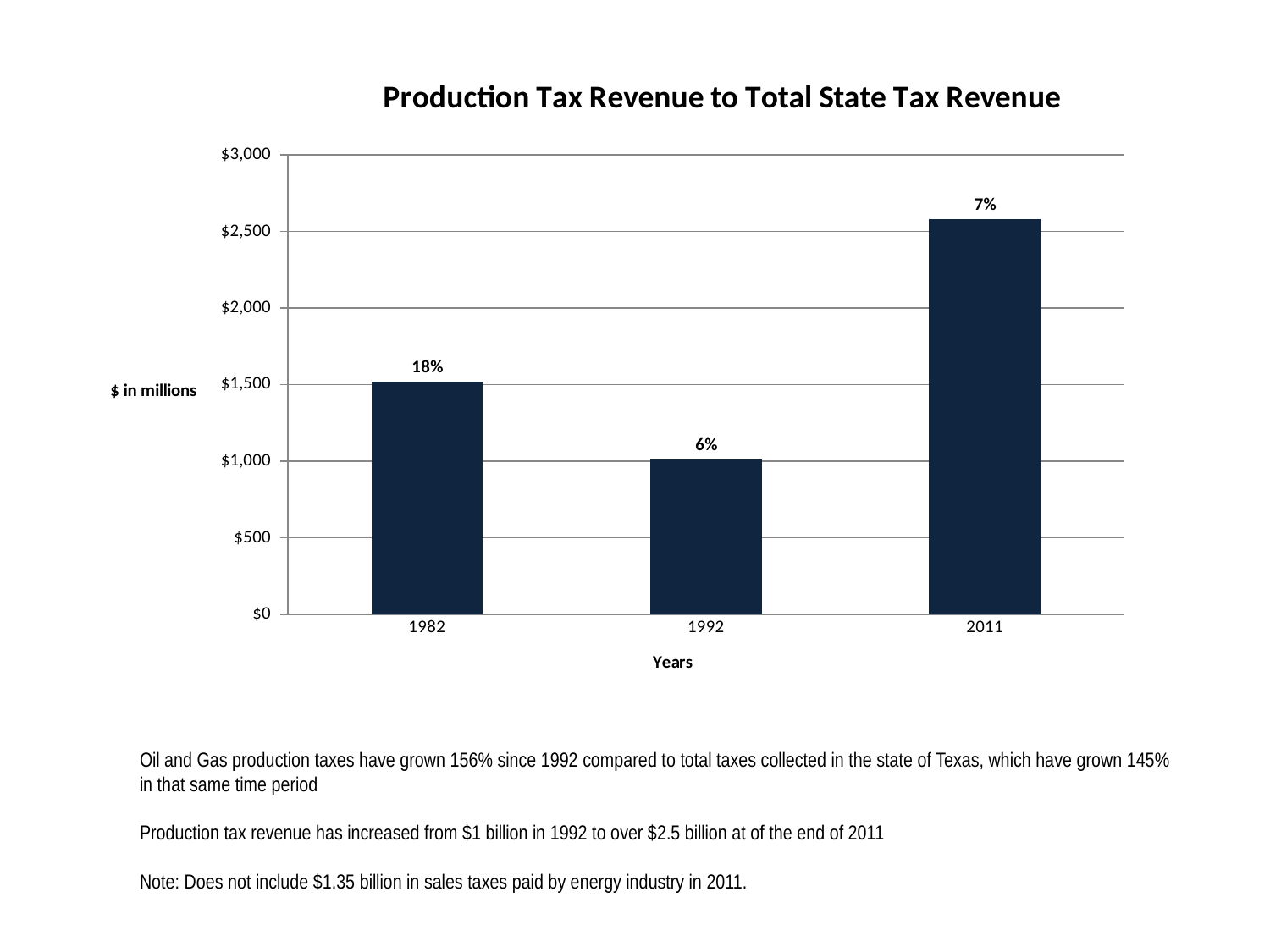
What percentage label is shown above the bar for 1992? 6% Which year has the tallest bar? 2011 Which bar is taller, 1982 or 1992? 1982 What percentage label is shown above the bar for 2011? 7% How many years are shown on the x axis? 3 Is the value for 1992 greater or less than $500? greater Is the value for 1982 greater or less than $2,000? less What is the label on the vertical axis of the chart? $ in millions Is the value for 2011 greater or less than $2,500? greater What percentage label is shown above the bar for 1982? 18% What kind of chart is shown on the slide? Bar chart Which year has the shortest bar? 1992